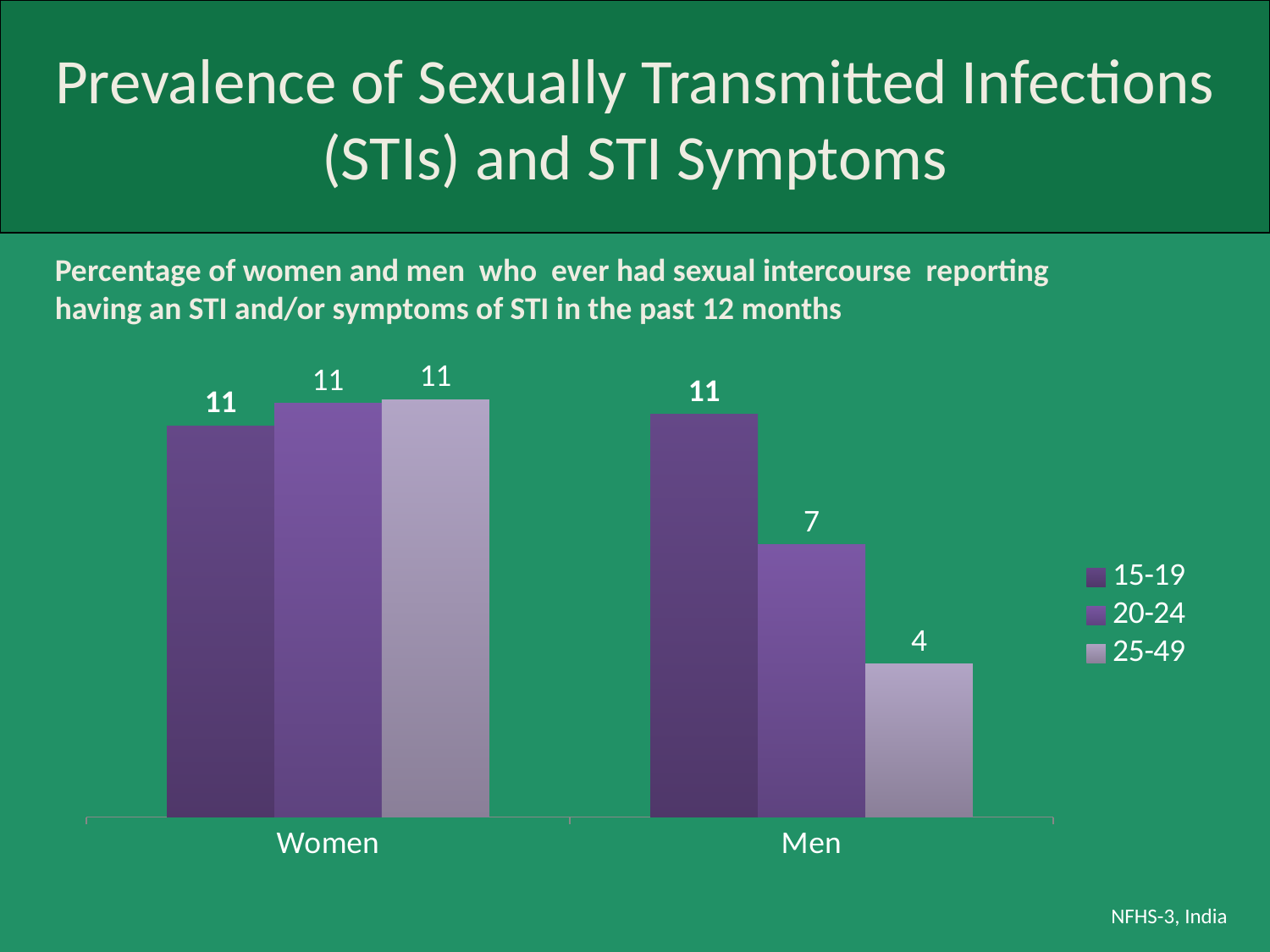
Which age group has the highest value among men? 15-19 Which age group has the lowest value among men? 25-49 How many categories are shown on the x axis? 2 Which is larger, the value for women aged 25-49 or men aged 25-49? Women aged 25-49 What is the value for women aged 25-49? 11 What is the difference between the values for women aged 20-24 and men aged 20-24? 4 What is the value for men aged 25-49? 4 How many series does the legend list? 3 What is the value for men aged 15-19? 11 What kind of chart is shown on the slide? Bar chart What is the difference between the values for men aged 15-19 and men aged 25-49? 7 What is the value for men aged 20-24? 7